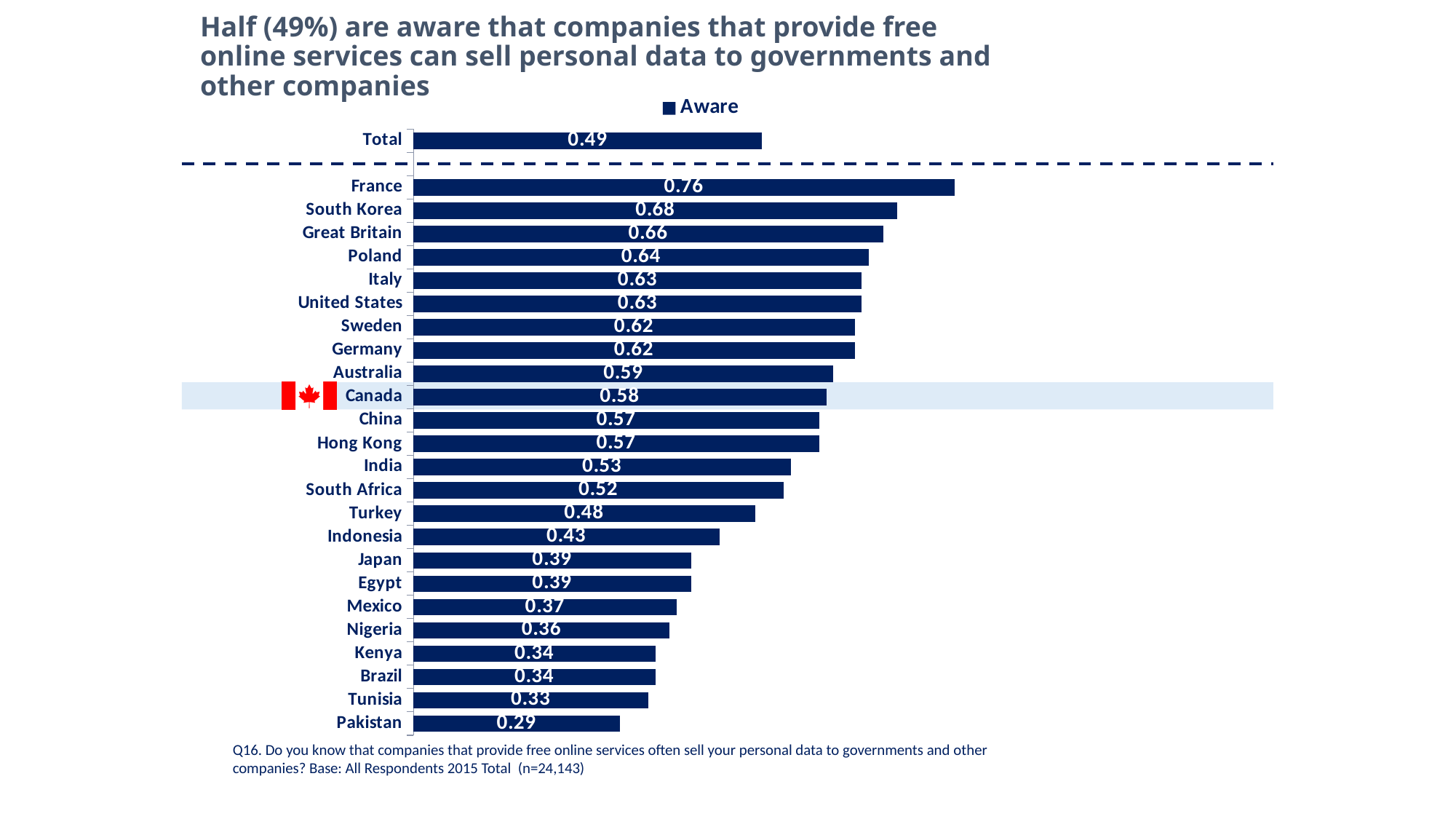
What is the difference between the values for France and Pakistan? 0.47 Which country has the lowest value? Pakistan Which has a larger value, Poland or India? Poland What kind of chart is shown? Bar chart How many countries are listed below the dashed line? 24 What is the value for Total? 0.49 Which country has the highest value? France What is the value for Indonesia? 0.43 What is the value for Canada? 0.58 Which has a larger value, Turkey or Japan? Turkey How many series does the legend list? 1 What is the difference between the values for South Korea and Canada? 0.10